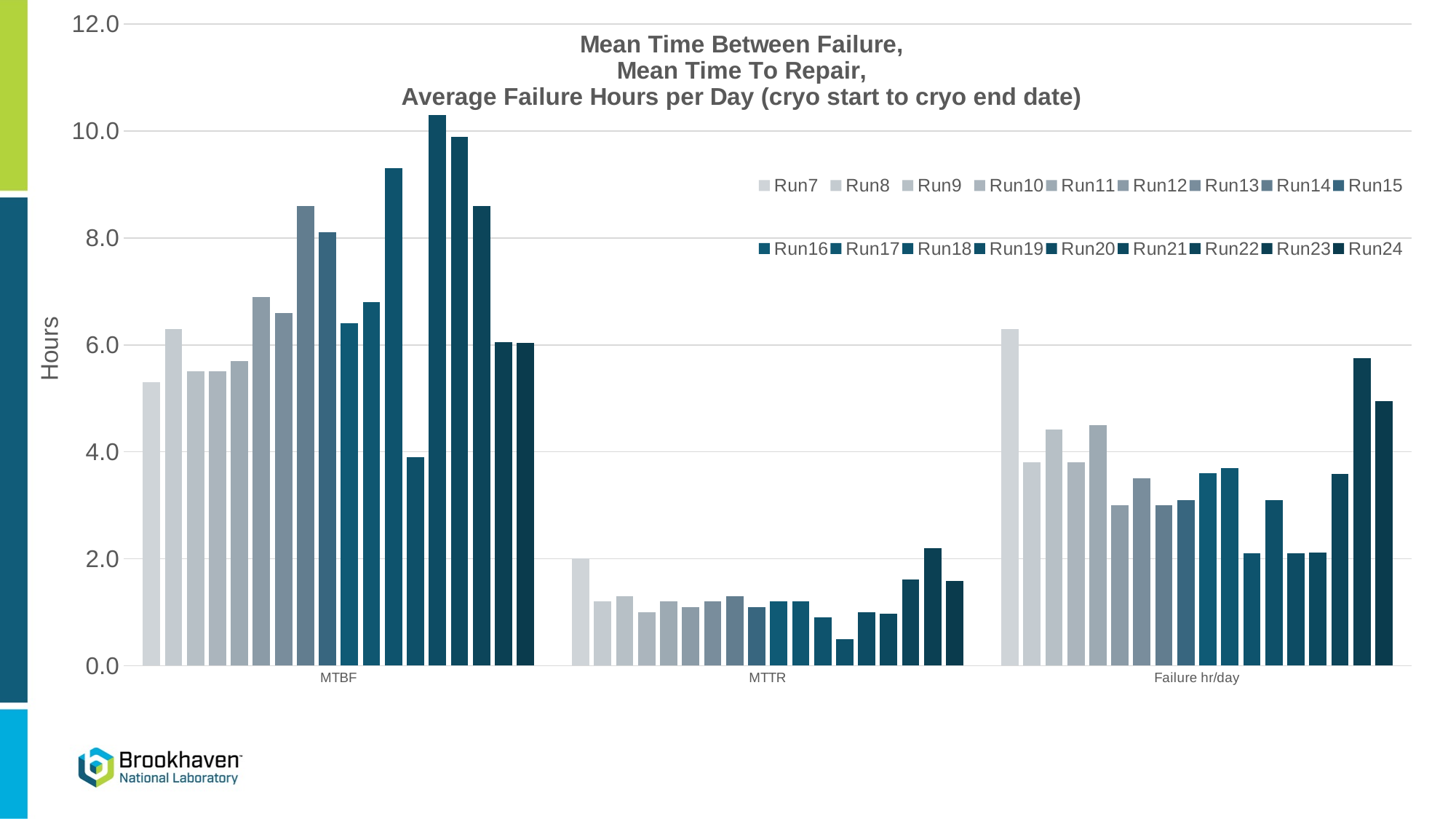
Which run has the highest Failure hr/day value? Run7 What kind of chart is shown on the slide? bar chart How many series does the chart's legend list? 18 Which run has the lowest MTBF value? Run19 Which run has the highest MTBF value? Run20 Which run has the lowest MTTR value? Run19 What is the label on the vertical axis of the chart? Hours Is the MTTR value for Run7 greater or less than 4.0? less Is the MTBF value for Run20 greater or less than 8.0? greater For MTBF, which is larger: Run7 or Run8? Run8 How many categories are shown on the x axis of the chart? 3 Which run has the highest MTTR value? Run23